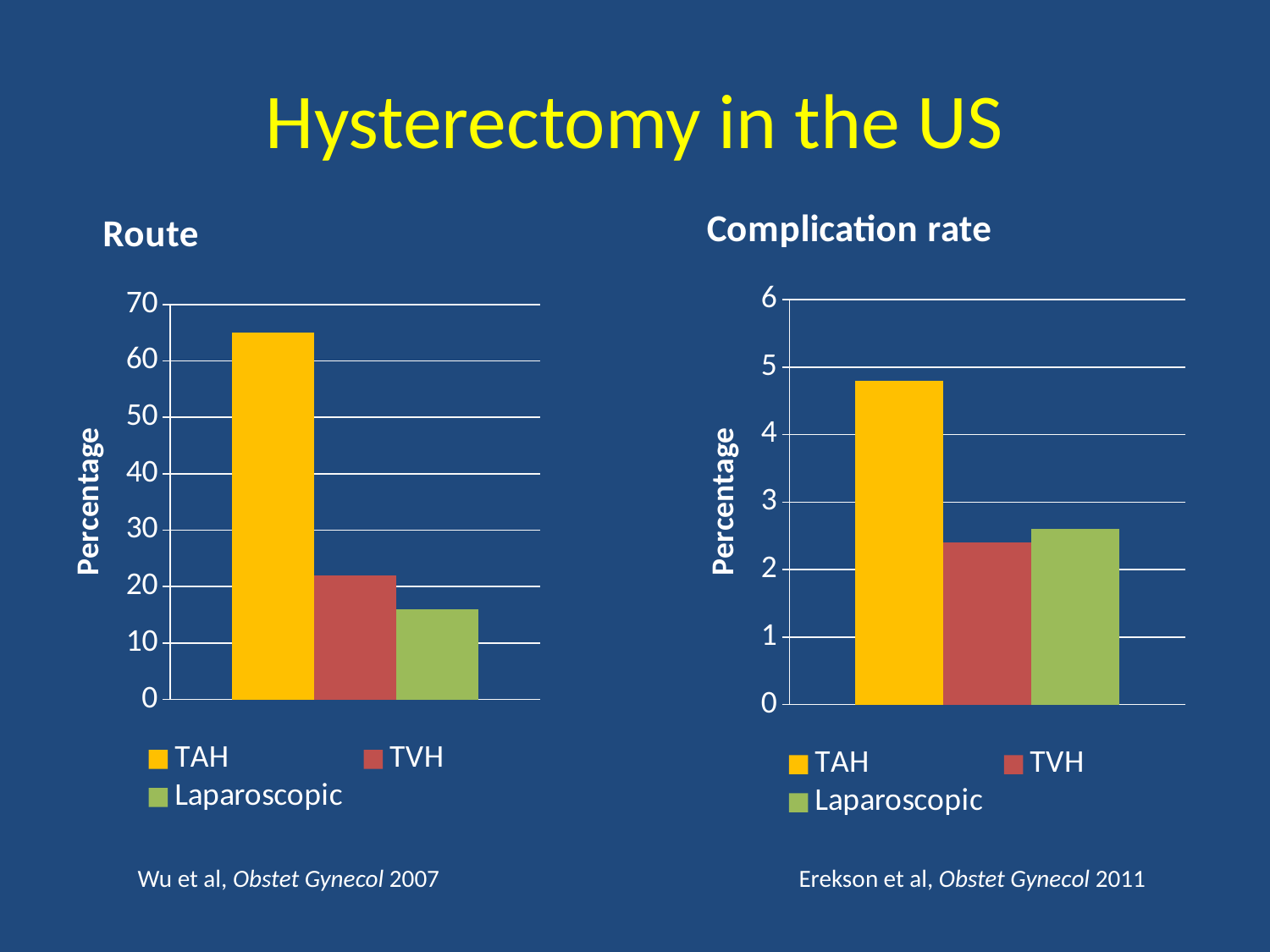
In the Complication rate chart, which series has the highest bar? TAH In the Complication rate chart, which is larger, the value for TAH or the value for TVH? TAH In the Route chart, is the value for TVH greater or less than 20? greater In the Route chart, which is larger, the value for TVH or the value for Laparoscopic? TVH In the Complication rate chart, is the value for Laparoscopic greater or less than 3? less In the Route chart, is the value for TAH greater or less than 60? greater In the Route chart, which series has the highest bar? TAH What kind of chart is the Route chart? Bar chart How many series does the legend of the Complication rate chart list? 3 In the Route chart, which series has the lowest bar? Laparoscopic